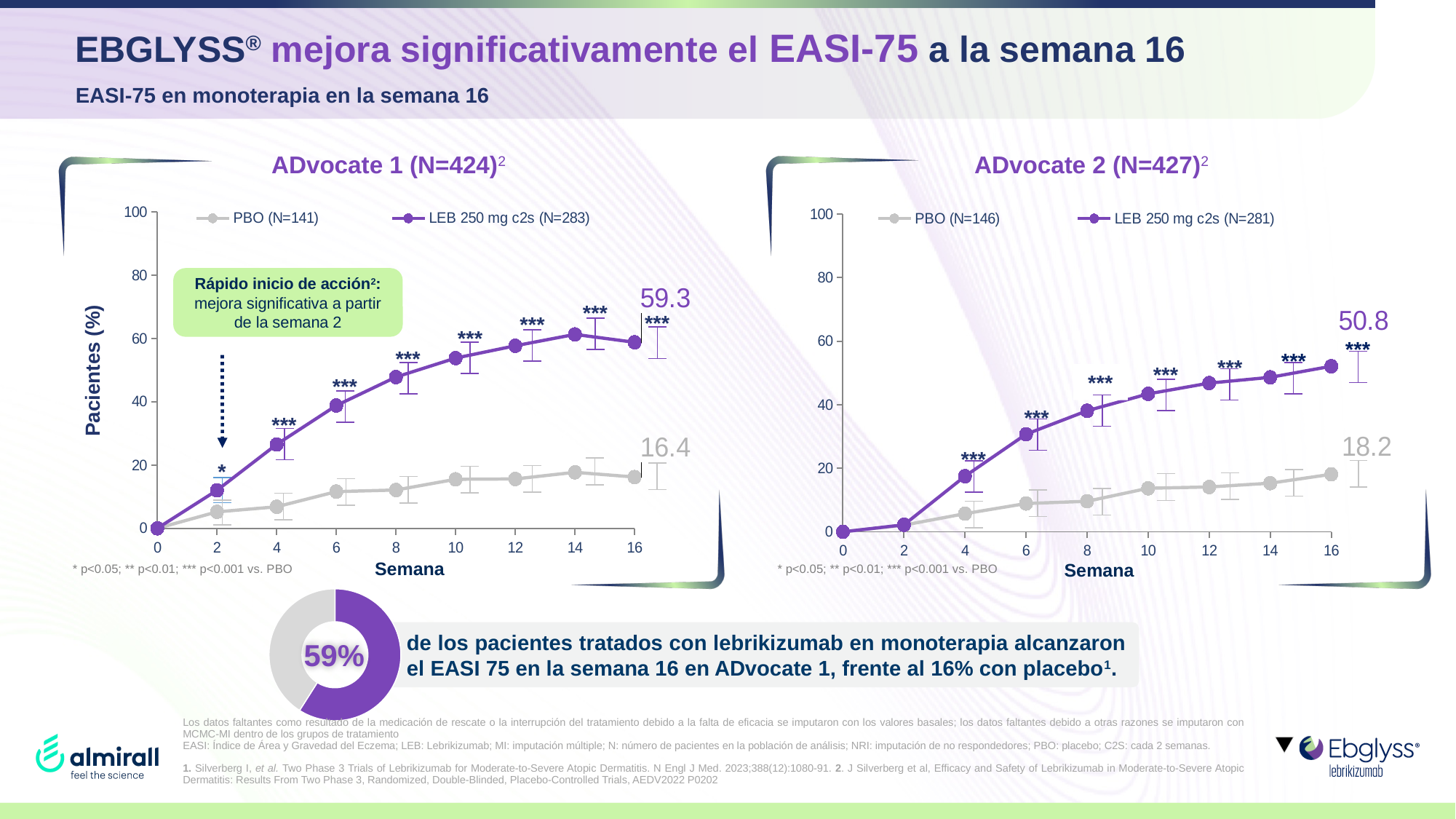
In the ADvocate 1 chart, what is the labelled value for PBO at week 16? 16.4 What kind of chart is used for ADvocate 2? line chart How many series does the legend of the ADvocate 1 chart list? 2 In the ADvocate 1 chart, what is the difference between the LEB 250 mg c2s and PBO values at week 16? 42.9 In the ADvocate 1 chart, is the value for LEB 250 mg c2s at week 8 greater or less than 40? greater In the ADvocate 2 chart, what is the labelled value for LEB 250 mg c2s at week 16? 50.8 In the ADvocate 2 chart, is the value for LEB 250 mg c2s at week 6 greater or less than 40? less In the ADvocate 2 chart, what is the labelled value for PBO at week 16? 18.2 What percentage is shown in the donut chart at the bottom of the slide? 59% In the ADvocate 1 chart, what is the labelled value for LEB 250 mg c2s at week 16? 59.3 In the ADvocate 2 chart, which series has the higher value at week 16, LEB 250 mg c2s or PBO? LEB 250 mg c2s In the ADvocate 2 chart, what is the difference between the LEB 250 mg c2s and PBO values at week 16? 32.6